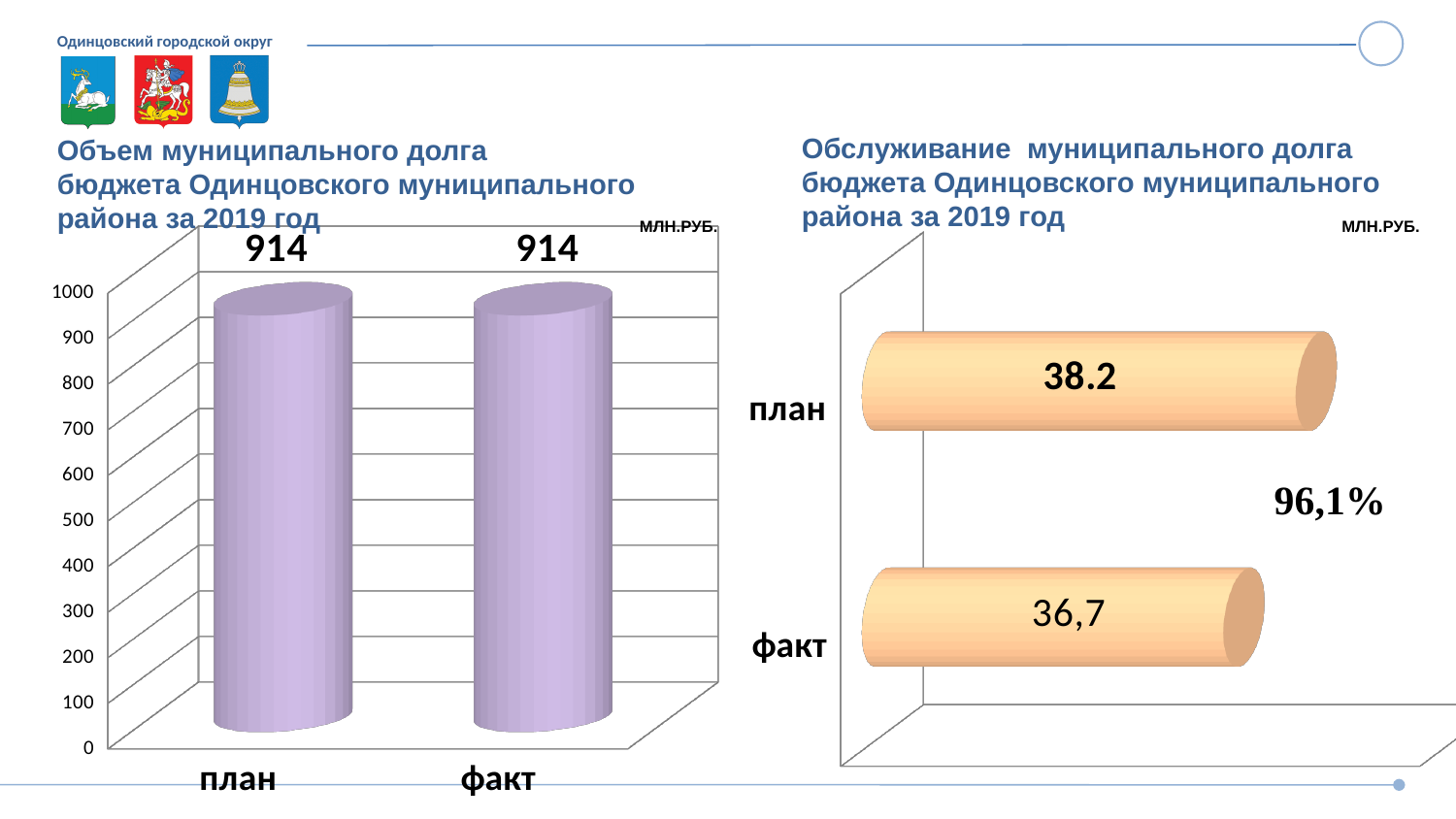
In the left chart (Объем муниципального долга), what is the value for факт? 914 In the right chart (Обслуживание муниципального долга), what is the value for факт? 36,7 In the right chart (Обслуживание муниципального долга), which category has the higher value, план or факт? план In the left chart (Объем муниципального долга), what is the value for план? 914 In the left chart (Объем муниципального долга), what is the highest value shown on the vertical axis? 1000 In the right chart (Обслуживание муниципального долга), which category has the lowest value? факт What percentage is printed next to the bars in the right chart (Обслуживание муниципального долга)? 96,1% In the left chart (Объем муниципального долга), what is the difference between план and факт? 0 In the right chart (Обслуживание муниципального долга), what is the value for план? 38.2 What kind of chart is the left chart (Объем муниципального долга)? bar chart What kind of chart is the right chart (Обслуживание муниципального долга)? bar chart In the left chart (Объем муниципального долга), how many bars are plotted? 2